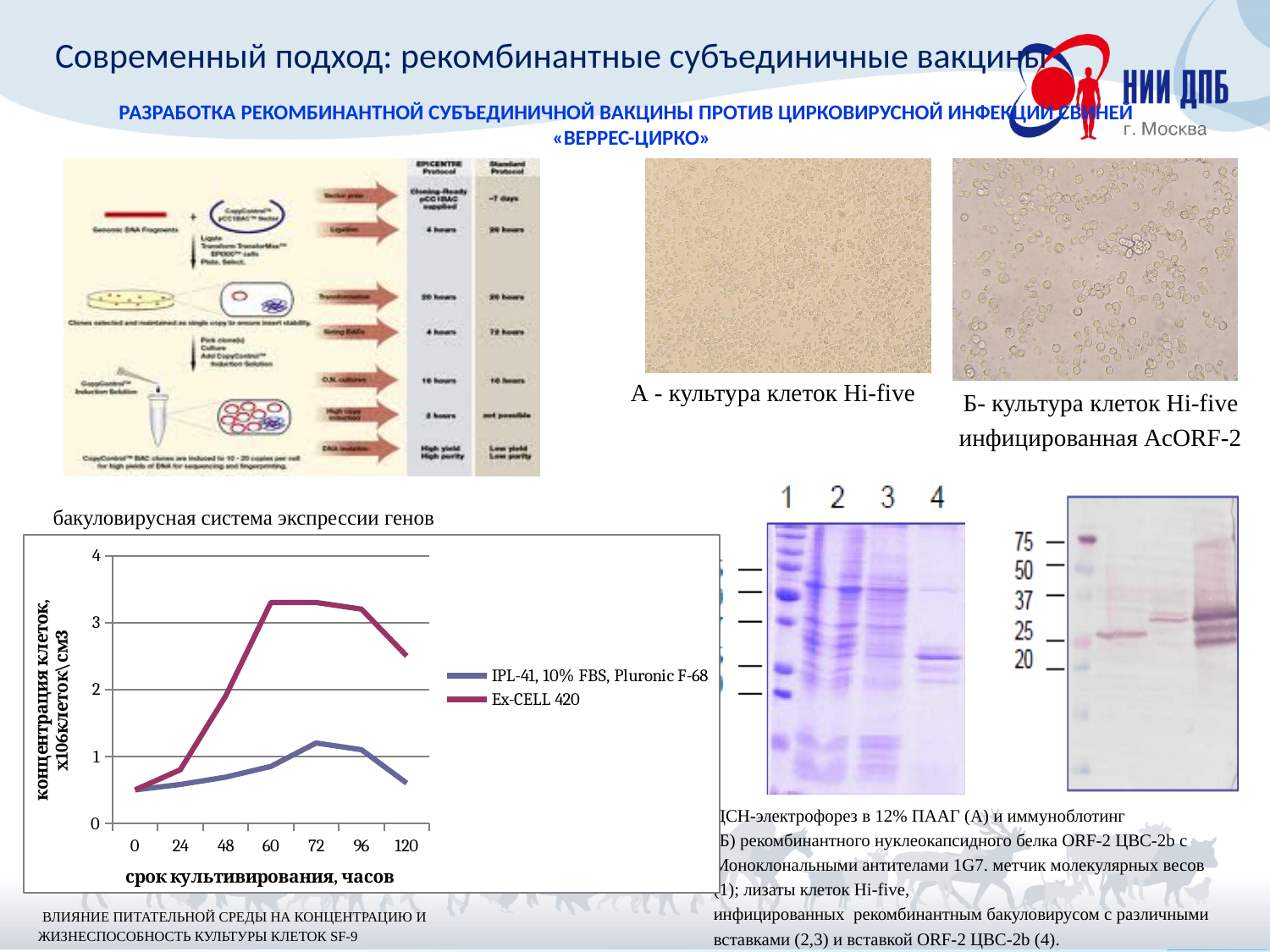
In the line chart, which series reaches the higher peak concentration? Ex-CELL 420 How many time points are marked on the x axis of the line chart? 7 In the line chart, is the value for Ex-CELL 420 at 72 hours greater or less than 3? greater In the line chart, which series has the higher value at 96 hours? Ex-CELL 420 In the line chart, does the IPL-41, 10% FBS, Pluronic F-68 series rise or fall between 72 and 120 hours? fall In the line chart, is the value for IPL-41, 10% FBS, Pluronic F-68 at 72 hours greater or less than 2? less In the line chart, does the Ex-CELL 420 series rise or fall between 0 and 60 hours? rise In the line chart, at which time point is the Ex-CELL 420 series lowest? 0 What kind of chart is shown at the bottom left of the slide? line chart In the line chart, is the value for Ex-CELL 420 at 120 hours greater or less than 2? greater What is the x-axis title of the line chart? срок культивирования, часов How many series does the legend of the line chart list? 2